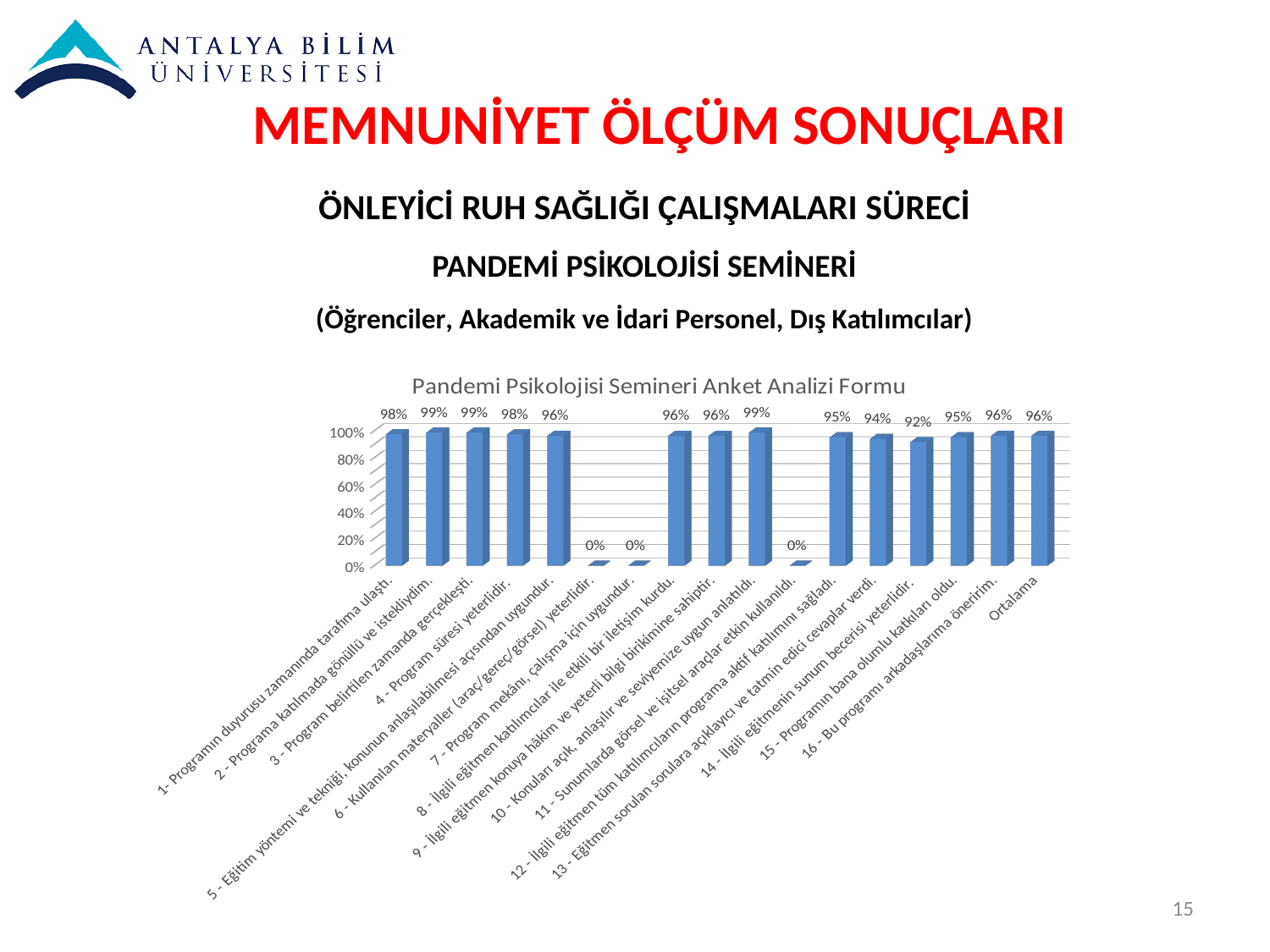
What is the difference between the value for item 2 (99%) and the value for item 14 (92%)? 7% Is the value for item 12 greater or less than 80%? greater What is the value for item 14 ("İlgili eğitmenin sunum becerisi yeterlidir.")? 92% How many categories in the chart show a value of 0%? 3 What is the title of the chart? Pandemi Psikolojisi Semineri Anket Analizi Formu Which is larger, the value for item 13 or the value for item 14? Item 13 Among the categories with a non-zero value, which has the lowest value? 14 - İlgili eğitmenin sunum becerisi yeterlidir. What is the value for item 13 ("Eğitmen sorulan sorulara açıklayıcı ve tatmin edici cevaplar verdi.")? 94% What is the value shown for "Ortalama" in the Pandemi Psikolojisi Semineri Anket Analizi Formu chart? 96% What is the value for item 1 ("Programın duyurusu zamanında tarafıma ulaştı.")? 98% What kind of chart is shown on the slide? Bar chart How many categories are plotted along the x axis of the chart? 17